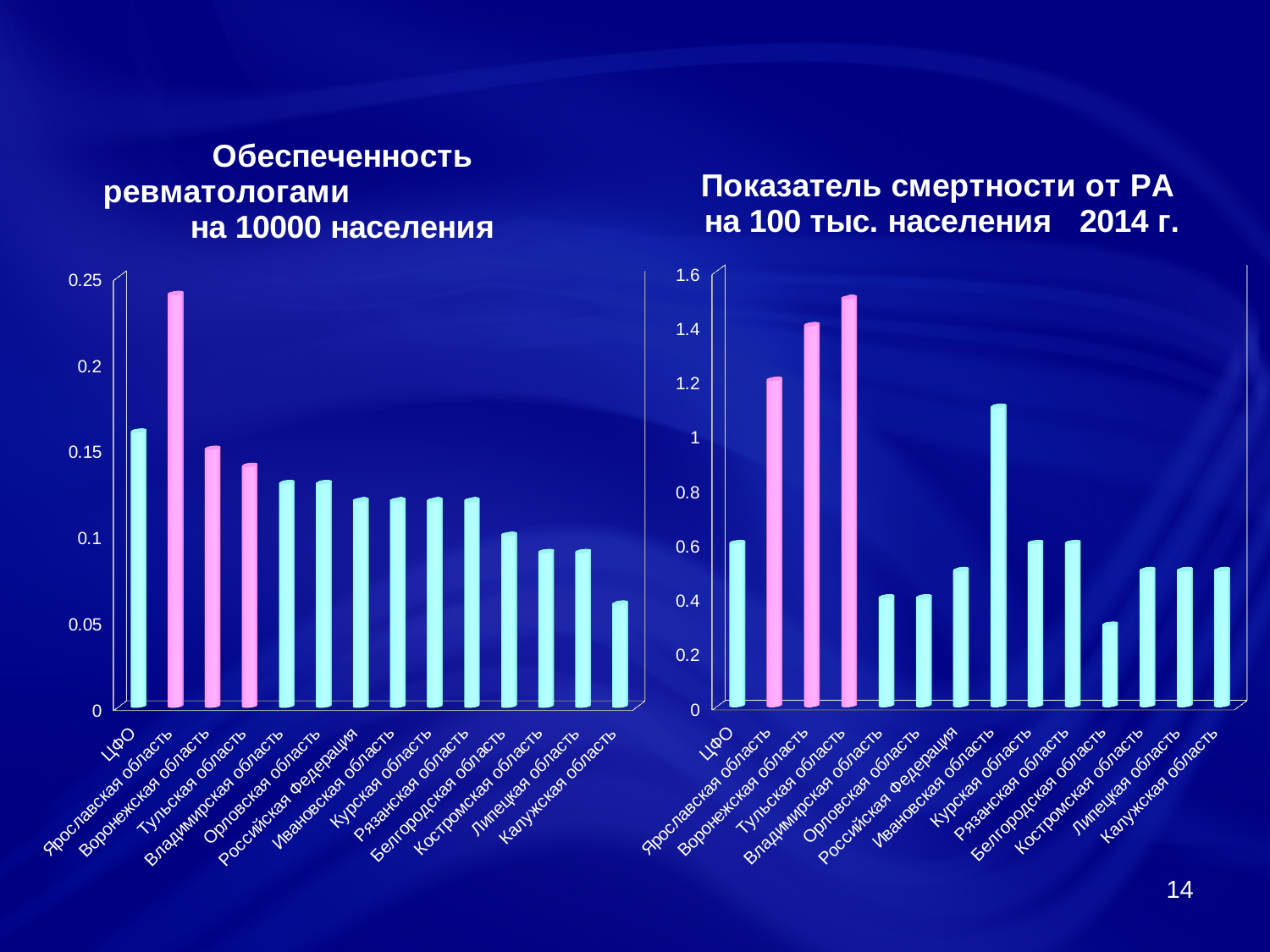
On the left chart (Обеспеченность ревматологами на 10000 населения), is the value for ЦФО greater or less than 0.15? greater What kind of chart is the left chart (Обеспеченность ревматологами на 10000 населения)? Bar chart On the right chart (Показатель смертности от РА на 100 тыс. населения 2014 г.), is the value for Костромская область greater or less than 0.4? greater On the left chart (Обеспеченность ревматологами на 10000 населения), which is larger: Ярославская область or Воронежская область? Ярославская область How many categories are shown on the right chart (Показатель смертности от РА на 100 тыс. населения 2014 г.)? 14 On the right chart (Показатель смертности от РА на 100 тыс. населения 2014 г.), which is larger: Ивановская область or Курская область? Ивановская область On the left chart (Обеспеченность ревматологами на 10000 населения), is the value for Калужская область greater or less than 0.1? less On the right chart (Показатель смертности от РА на 100 тыс. населения 2014 г.), which category has the lowest value? Белгородская область On the left chart (Обеспеченность ревматологами на 10000 населения), which category has the lowest value? Калужская область On the right chart (Показатель смертности от РА на 100 тыс. населения 2014 г.), which category has the highest value? Тульская область On the left chart (Обеспеченность ревматологами на 10000 населения), which category has the highest value? Ярославская область